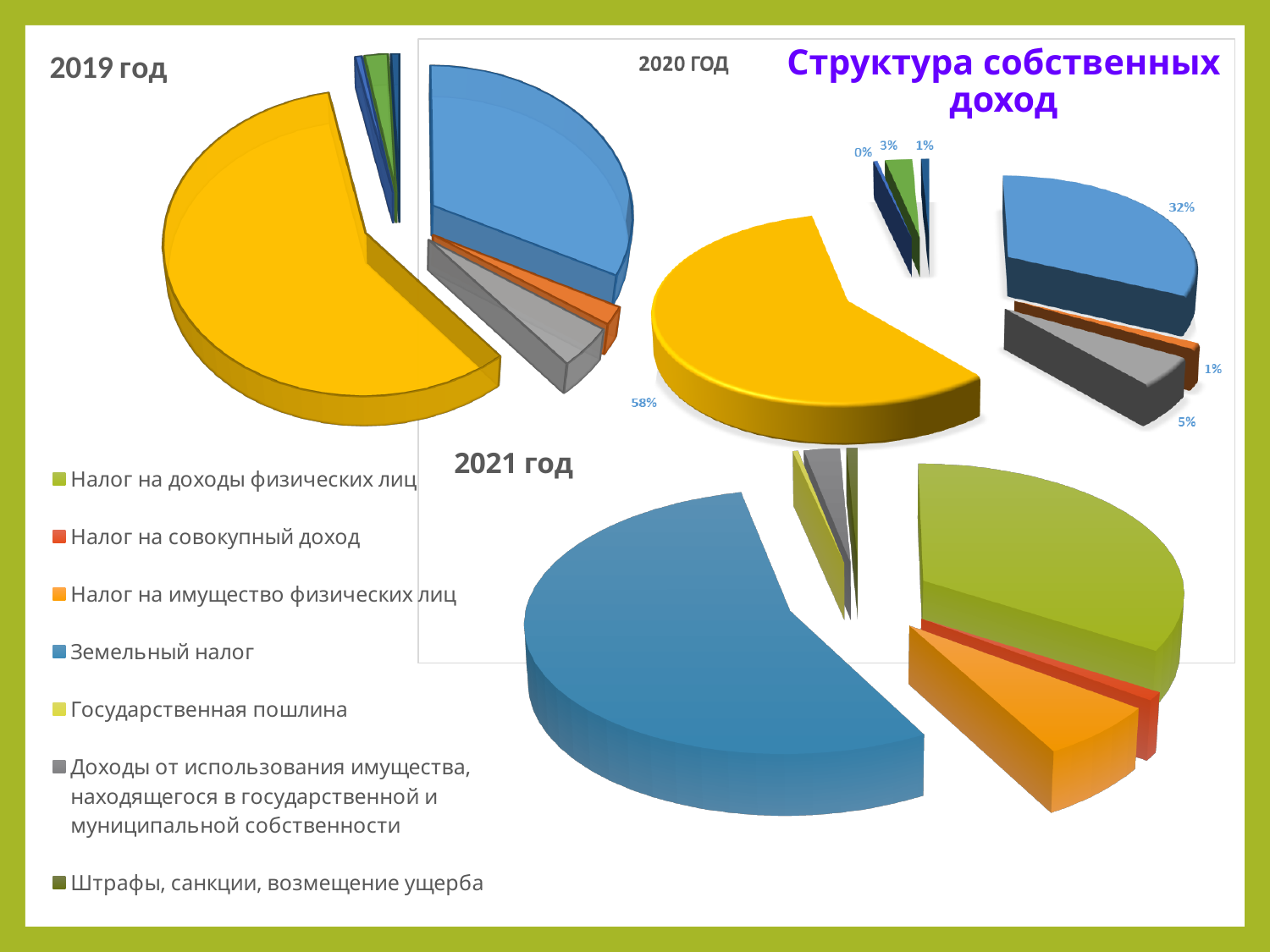
In the 2020 год chart, what is the value of the second-largest (blue) slice? 32% How many slices have data labels in the 2020 год chart? 7 In the 2020 год chart, what is the smallest labelled value? 0% How many pie charts are shown on the slide? 3 What is the title of the slide's charts? Структура собственных доход In the 2020 год chart, what is the value of the largest slice? 58% In the 2021 год chart, which category has the largest slice? Земельный налог In the 2020 год chart, what is the difference between the largest slice (58%) and the blue slice (32%)? 26 percentage points In the 2020 год chart, what is the value of the grey slice? 5% What kind of chart is used for each year on the slide? Pie chart How many entries does the legend list? 7 In the 2021 год chart, which is larger: Земельный налог or Налог на доходы физических лиц? Земельный налог